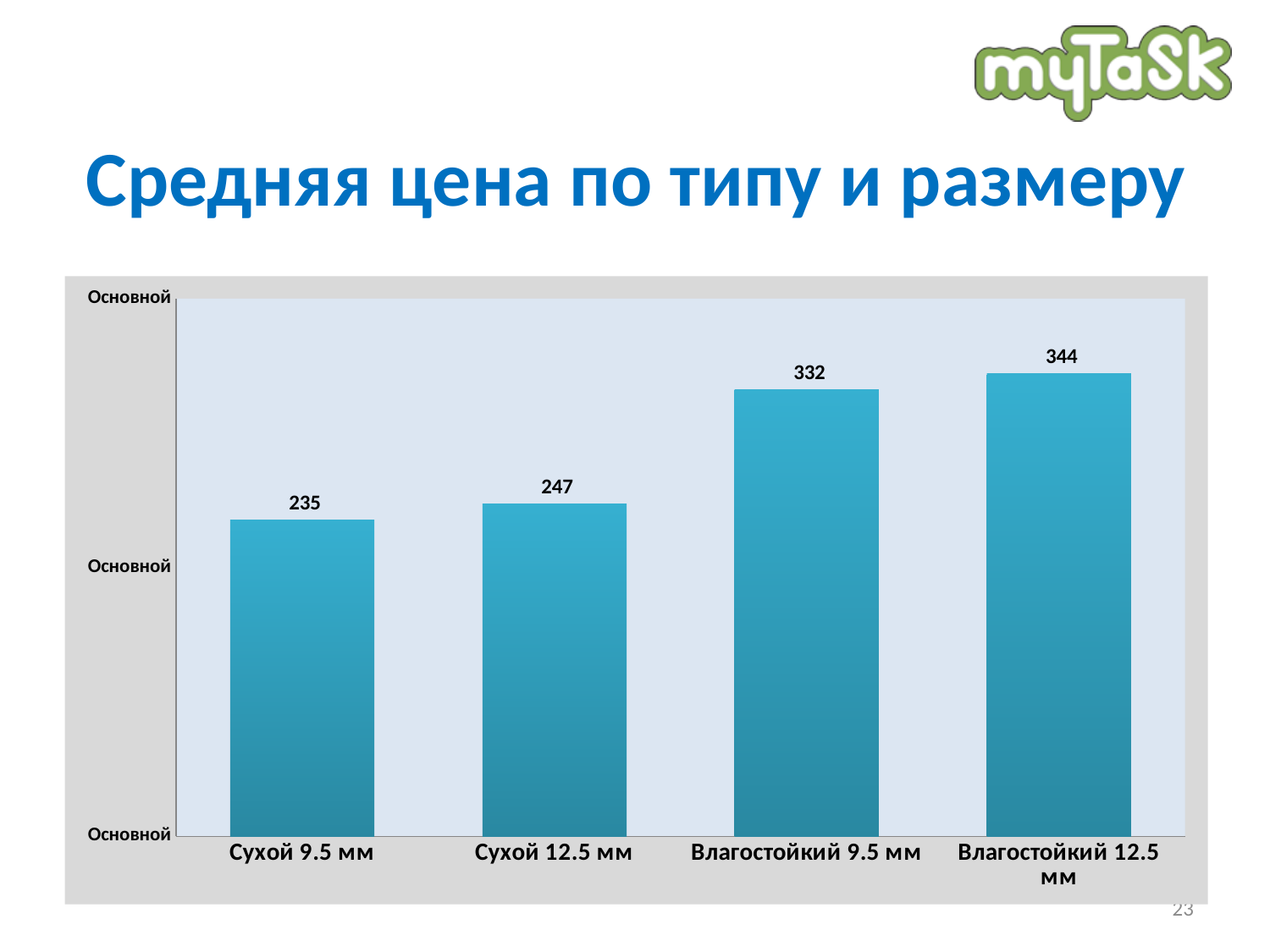
What is the difference between the average price for Влагостойкий 12.5 мм and Сухой 9.5 мм? 109 Which category has the highest average price? Влагостойкий 12.5 мм What is the average price for Сухой 9.5 мм? 235 What is the average price for Сухой 12.5 мм? 247 What is the average price for Влагостойкий 9.5 мм? 332 What kind of chart is shown on the slide? Bar chart How many categories are shown on the chart? 4 Which category has the lowest average price? Сухой 9.5 мм What is the average price for Влагостойкий 12.5 мм? 344 Do the values rise or fall from left to right across the categories? Rise Which is larger: the average price for Сухой 12.5 мм or Влагостойкий 9.5 мм? Влагостойкий 9.5 мм What is the difference between the average price for Влагостойкий 9.5 мм and Сухой 12.5 мм? 85